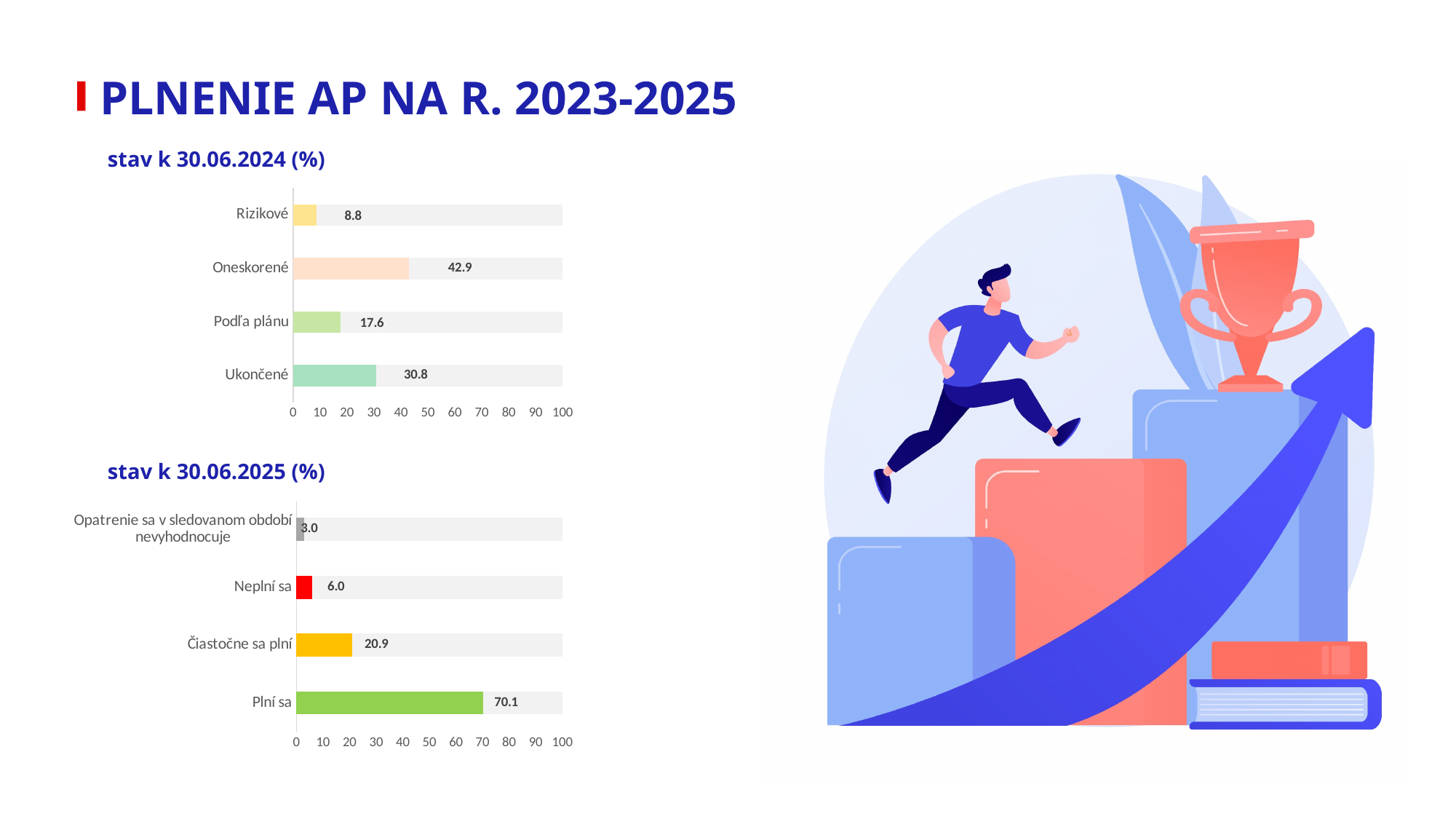
In the 'stav k 30.06.2025 (%)' chart, what is the value for Čiastočne sa plní? 20.9 In the 'stav k 30.06.2024 (%)' chart, what is the difference between Ukončené and Podľa plánu? 13.2 What type of chart is the 'stav k 30.06.2025 (%)' chart? Bar chart In the 'stav k 30.06.2024 (%)' chart, what is the value for Oneskorené? 42.9 In the 'stav k 30.06.2024 (%)' chart, how many categories are shown? 4 In the 'stav k 30.06.2025 (%)' chart, which category has the lowest value? Opatrenie sa v sledovanom období nevyhodnocuje In the 'stav k 30.06.2024 (%)' chart, which category has the highest value? Oneskorené In the 'stav k 30.06.2025 (%)' chart, what is the value for Plní sa? 70.1 In the 'stav k 30.06.2024 (%)' chart, which category has the lowest value? Rizikové In the 'stav k 30.06.2024 (%)' chart, what is the value for Ukončené? 30.8 In the 'stav k 30.06.2025 (%)' chart, what is the difference between Plní sa and Čiastočne sa plní? 49.2 In the 'stav k 30.06.2025 (%)' chart, which is larger: Neplní sa or Čiastočne sa plní? Čiastočne sa plní